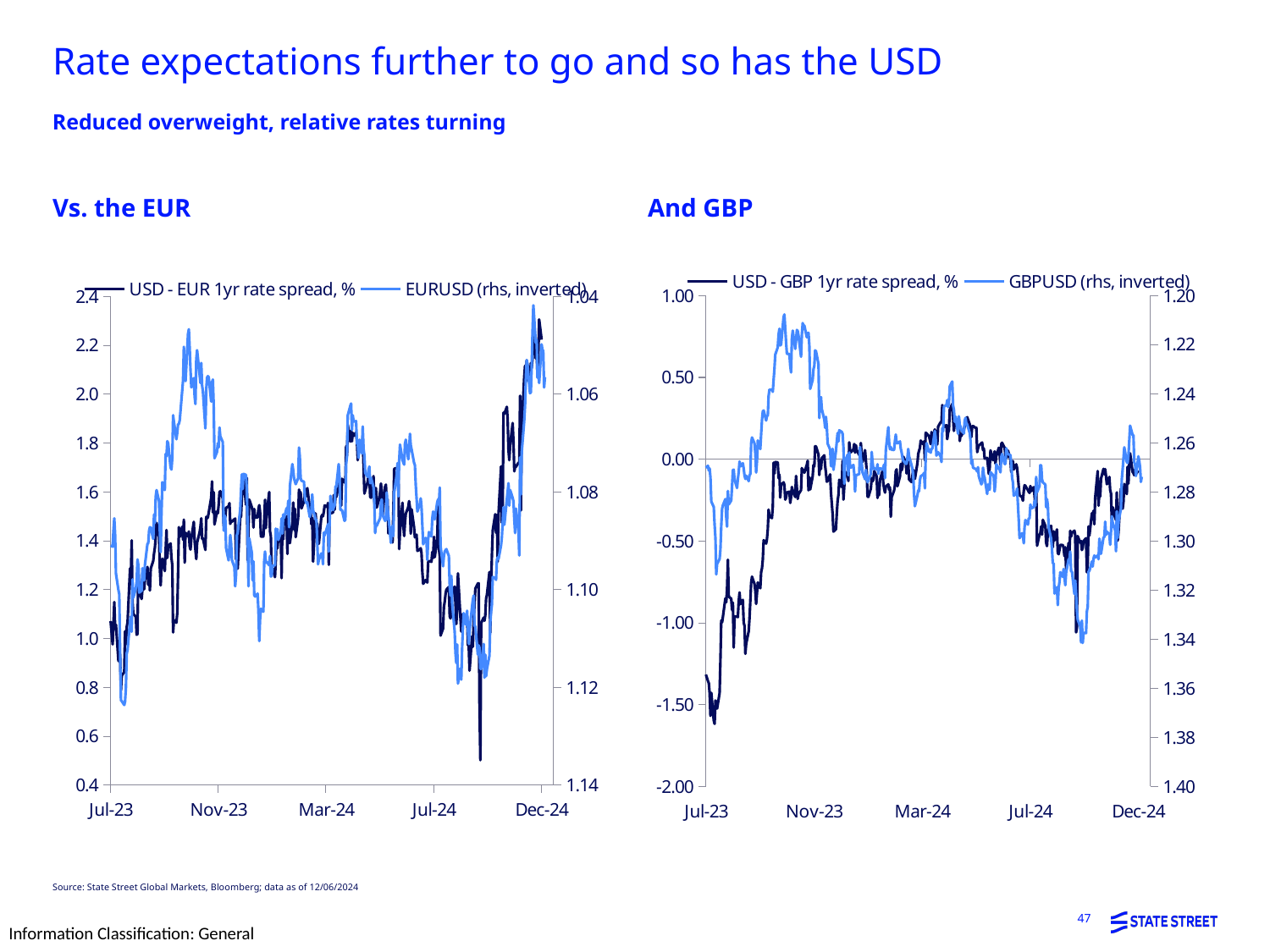
In the 'Vs. the EUR' chart, is the USD - EUR 1yr rate spread at Jul-23 greater or less than 1.4? less In the 'Vs. the EUR' chart, what is the name of the series plotted on the right-hand axis? EURUSD (rhs, inverted) In the 'Vs. the EUR' chart, does the USD - EUR 1yr rate spread rise or fall between Jul-24 and Dec-24? rise In the 'And GBP' chart, what is the name of the dark blue series? USD - GBP 1yr rate spread, % In the 'And GBP' chart, is the USD - GBP 1yr rate spread at Jul-23 greater or less than -1.00? less How many date labels are shown on the x axis of the 'And GBP' chart? 5 What kind of chart is the 'Vs. the EUR' chart on the left? line chart In the 'Vs. the EUR' chart, is the USD - EUR 1yr rate spread at Dec-24 greater or less than 2.0? greater In the 'And GBP' chart, does the USD - GBP 1yr rate spread rise or fall between Jul-23 and Nov-23? rise In the 'And GBP' chart, what is the lowest value shown on the left-hand axis? -2.00 How many series does the legend of the 'And GBP' chart list? 2